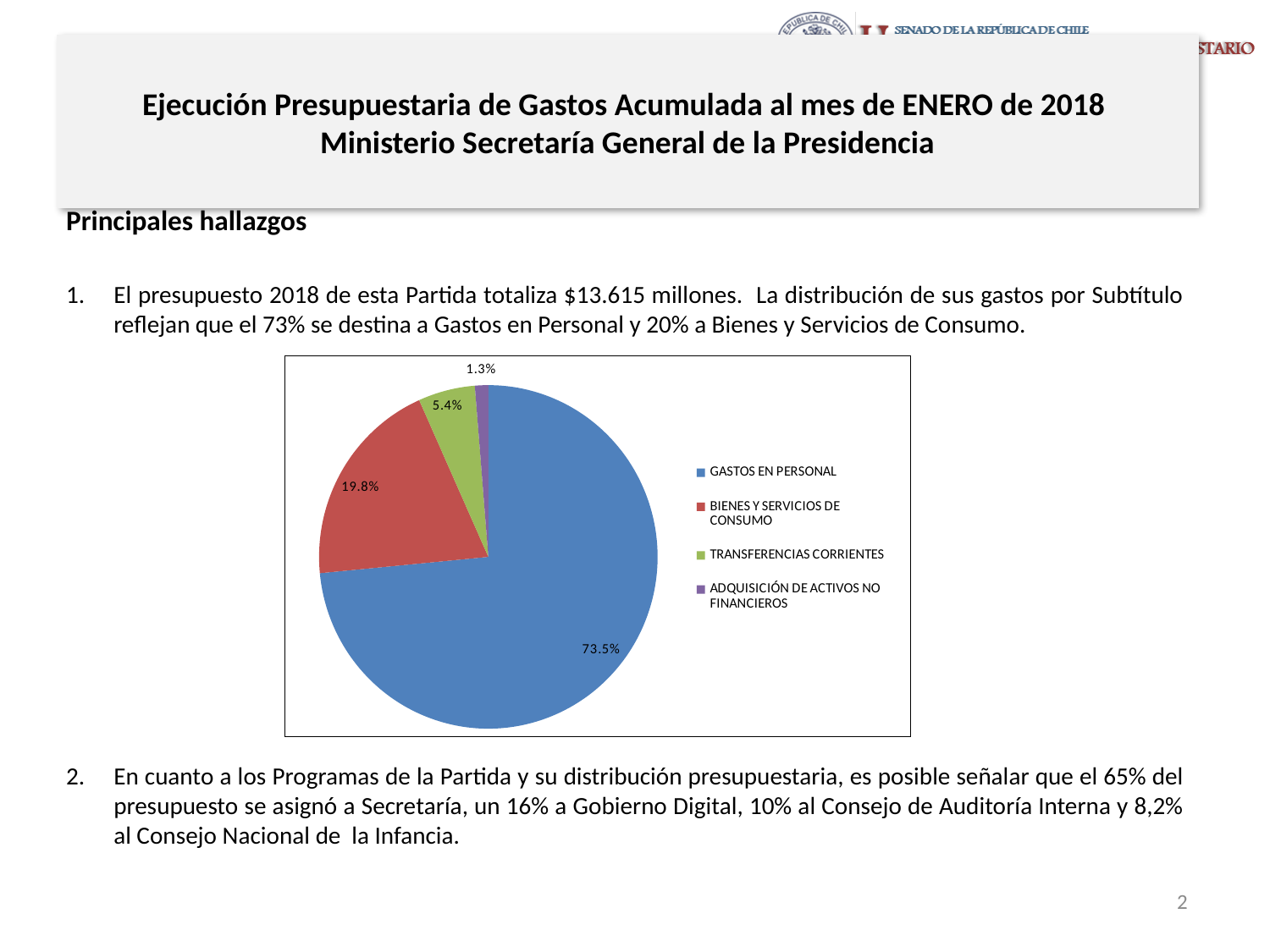
Which category has the smallest slice of the pie? ADQUISICIÓN DE ACTIVOS NO FINANCIEROS What kind of chart is shown on the slide? pie chart What share of the pie does TRANSFERENCIAS CORRIENTES represent? 5.4% Which category has the largest slice of the pie? GASTOS EN PERSONAL What share of the pie does GASTOS EN PERSONAL represent? 73.5% Which is larger, the slice for TRANSFERENCIAS CORRIENTES or the slice for ADQUISICIÓN DE ACTIVOS NO FINANCIEROS? TRANSFERENCIAS CORRIENTES What colour is the slice for BIENES Y SERVICIOS DE CONSUMO? red What is the difference in percentage points between GASTOS EN PERSONAL and BIENES Y SERVICIOS DE CONSUMO? 53.7 What share of the pie does ADQUISICIÓN DE ACTIVOS NO FINANCIEROS represent? 1.3% What colour is the slice for GASTOS EN PERSONAL? blue How many categories does the pie chart show? 4